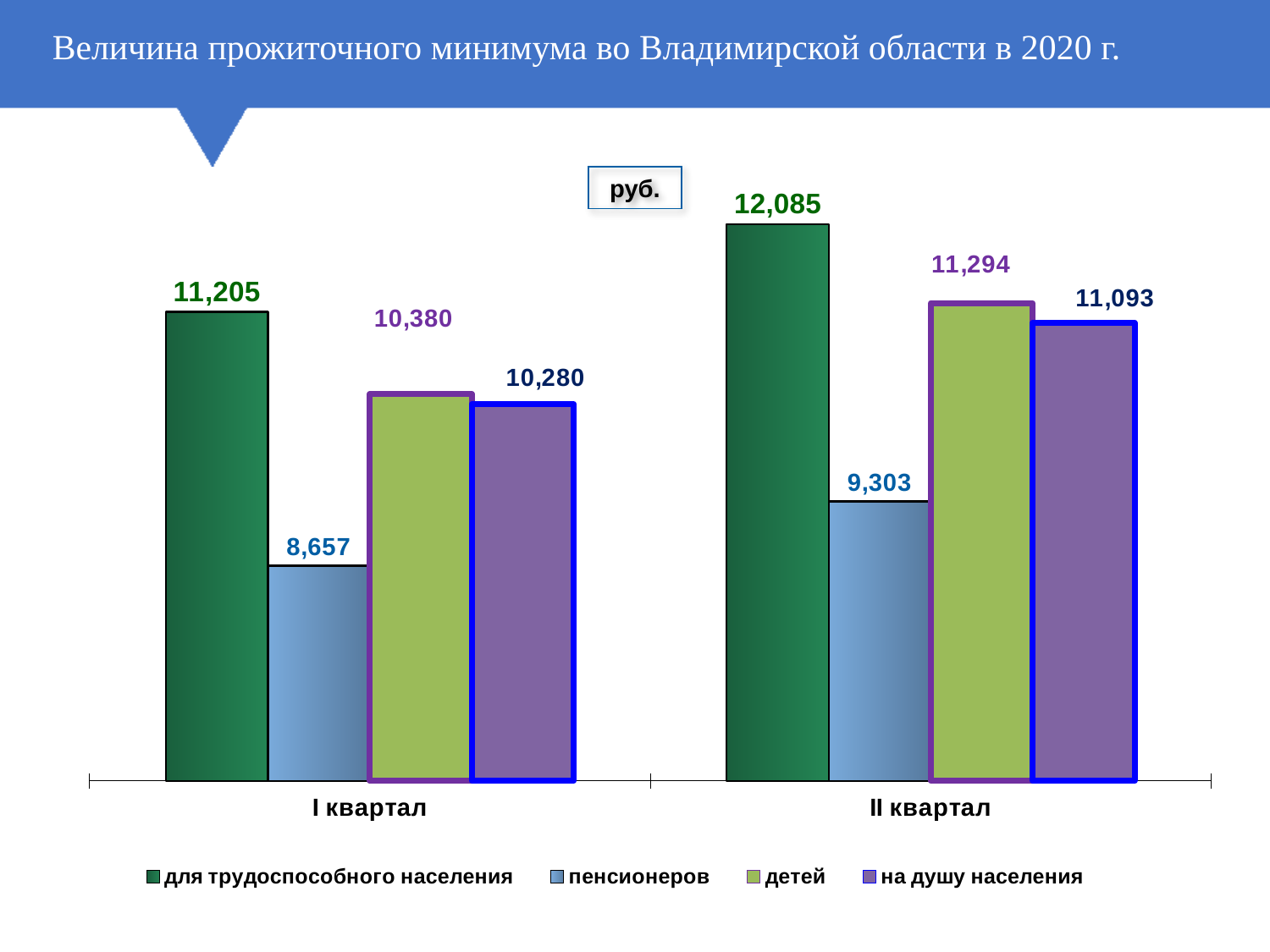
Which is larger: the value for "пенсионеров" in I квартал or in II квартал? II квартал What kind of chart is shown on the slide? bar chart What is the difference between the value for "для трудоспособного населения" in II квартал and in I квартал? 880 What is the value for "пенсионеров" in II квартал? 9,303 What is the value for "на душу населения" in II квартал? 11,093 How many categories are shown on the x axis? 2 What is the difference between the values for "детей" and "на душу населения" in I квартал? 100 What is the value for "детей" in I квартал? 10,380 What is the value for "для трудоспособного населения" in I квартал? 11,205 Which series has the lowest value in I квартал? пенсионеров Which series has the highest value in II квартал? для трудоспособного населения How many series does the legend list? 4